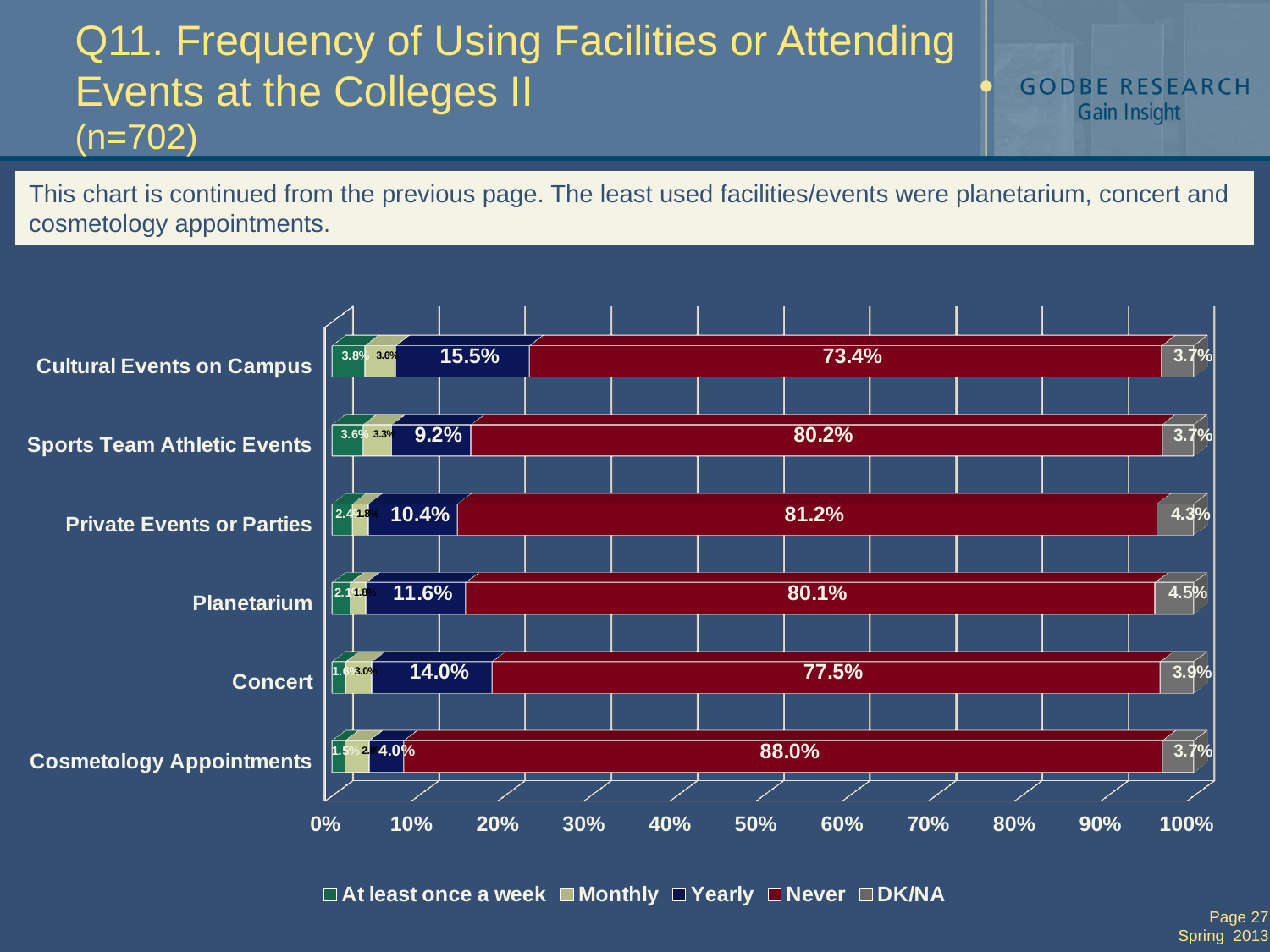
How many categories (facilities/events) are shown on the chart? 6 How many series does the legend list? 5 What is the 'Yearly' value for Cultural Events on Campus? 15.5% What percentage of respondents said they never attend Cosmetology Appointments? 88.0% Which category has the highest 'Never' percentage? Cosmetology Appointments Which has a larger 'Yearly' value, Concert or Planetarium? Concert Which category has the lowest 'Never' percentage? Cultural Events on Campus What is the DK/NA value for Planetarium? 4.5% What is the 'Never' value for Sports Team Athletic Events? 80.2% Which category has the highest 'Yearly' percentage? Cultural Events on Campus What is the difference between the 'Never' values for Cosmetology Appointments and Cultural Events on Campus? 14.6% What kind of chart is shown on the slide? Stacked bar chart